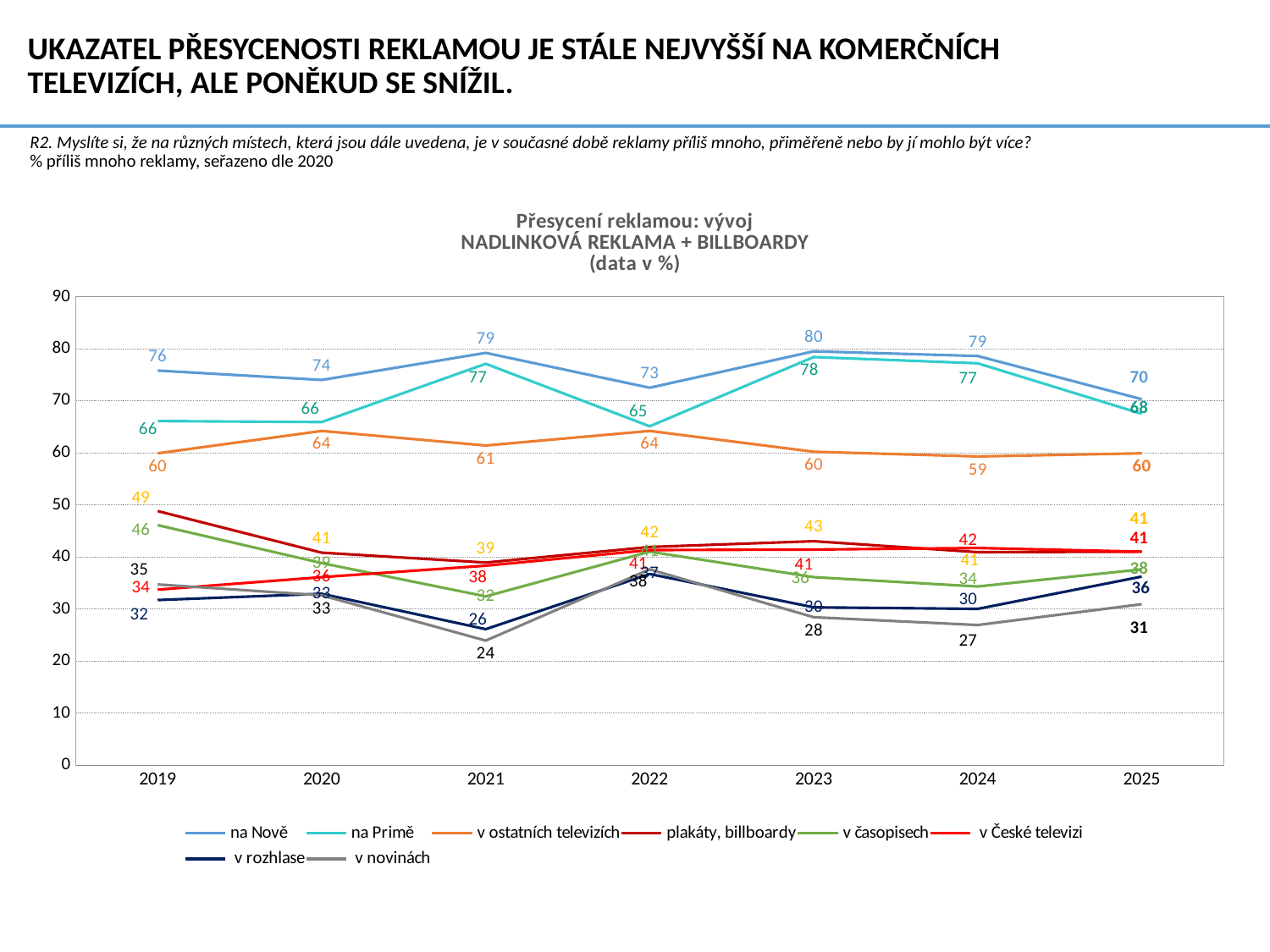
Which is larger in 2022, the value for na Nově or the value for na Primě? na Nově How many years are plotted along the x axis? 7 What is the value for v novinách in 2021? 24 In which year is the value for v novinách lowest? 2021 In which year does na Nově reach its highest value? 2023 What is the difference between the na Nově values in 2019 and 2025? 6 How many series does the legend list? 8 What is the value for na Primě in 2025? 68 Does the na Nově line rise or fall from 2023 to 2025? fall What type of chart is shown on the slide? line chart What is the value for v ostatních televizích in 2024? 59 What is the value for na Nově in 2023? 80